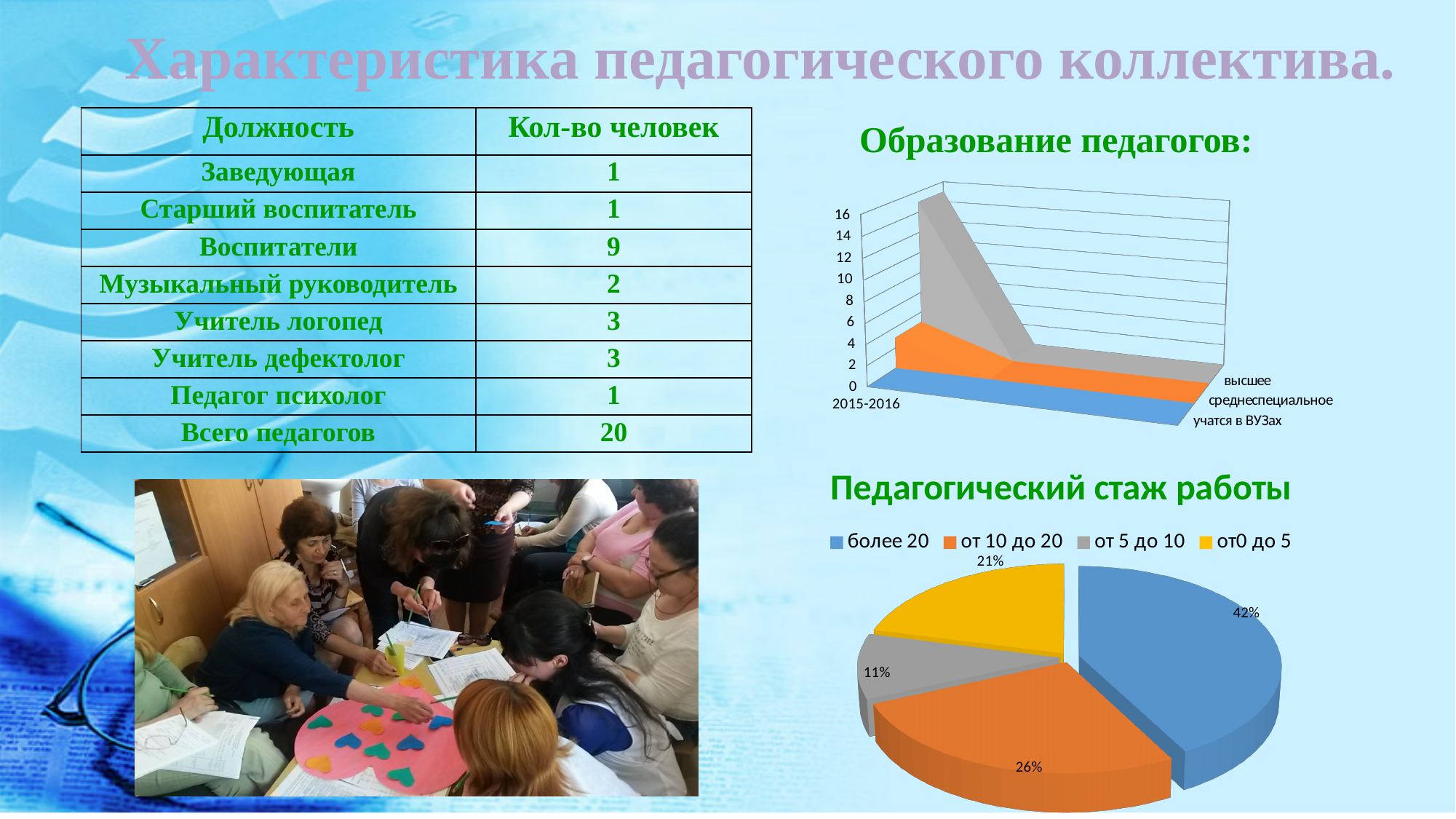
In the chart 'Образование педагогов:', which category label is shown on the horizontal axis? 2015-2016 In the pie chart 'Педагогический стаж работы', what share is shown for 'от 5 до 10'? 11% What kind of chart is 'Педагогический стаж работы'? Pie chart In the pie chart 'Педагогический стаж работы', which is larger: the share for 'от0 до 5' or the share for 'от 5 до 10'? от0 до 5 In the pie chart 'Педагогический стаж работы', which category has the smallest share? от 5 до 10 How many entries does the legend of the pie chart 'Педагогический стаж работы' list? 4 In the chart 'Образование педагогов:', is the value for 'высшее' greater or less than 8? greater In the pie chart 'Педагогический стаж работы', what share is shown for 'от0 до 5'? 21% In the pie chart 'Педагогический стаж работы', what share is shown for 'от 10 до 20'? 26% In the pie chart 'Педагогический стаж работы', what is the difference between the shares for 'более 20' and 'от 10 до 20'? 16% In the pie chart 'Педагогический стаж работы', which category has the largest share? более 20 In the pie chart 'Педагогический стаж работы', what share is shown for 'более 20'? 42%